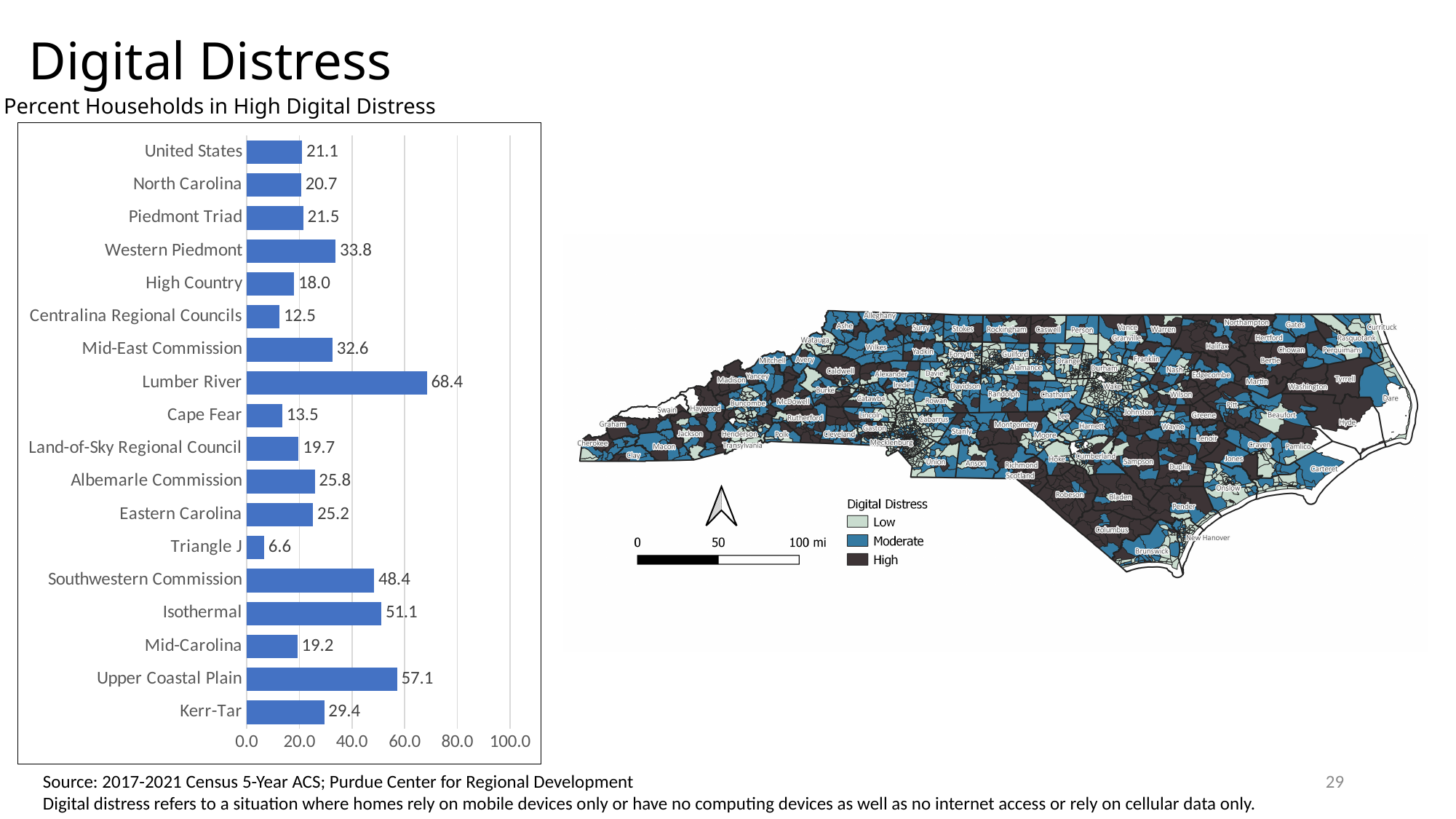
What is the title of the bar chart? Percent Households in High Digital Distress Which category has the lowest value in the bar chart? Triangle J How many categories are shown in the bar chart? 18 What is the difference between the values for United States and North Carolina? 0.4 What is the difference between the values for Upper Coastal Plain and Kerr-Tar? 27.7 Which has a larger value, Isothermal or Southwestern Commission? Isothermal What is the value for Lumber River in the bar chart? 68.4 What kind of chart is shown on the left of the slide? Bar chart What is the value for North Carolina in the bar chart? 20.7 Which category has the highest value in the bar chart? Lumber River What is the value for Triangle J in the bar chart? 6.6 Is the value for Western Piedmont greater or less than 20.0? greater